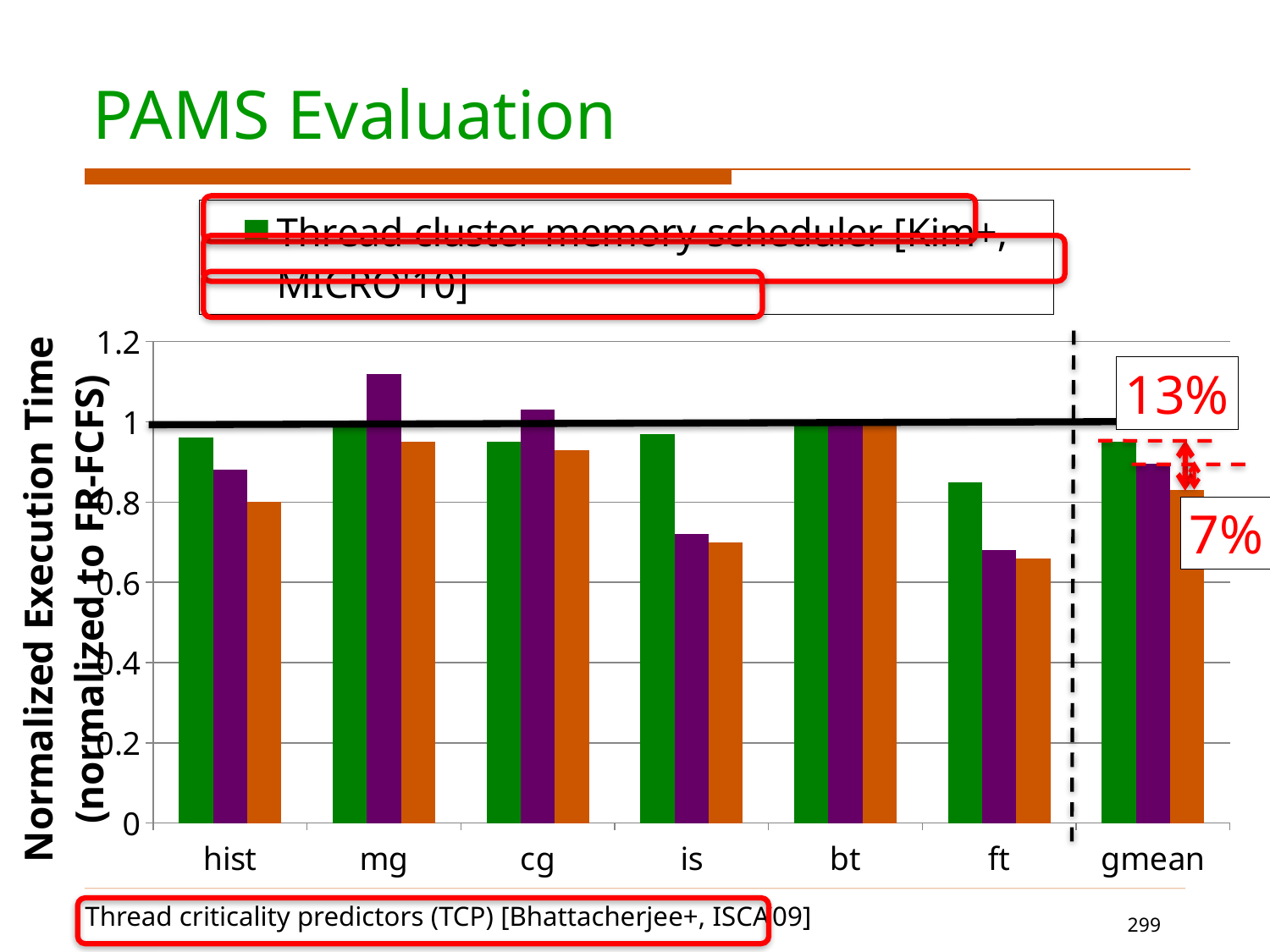
Is the purple bar for mg greater or less than 1? greater Which category has the shortest orange bar? ft How many categories are shown on the x axis of the chart? 7 Which category has the tallest purple bar? mg Is the purple bar for is greater or less than 0.8? less For mg, which is larger: the purple bar or the orange bar? purple bar How many bars (series) are plotted for each category in the chart? 3 What is the y-axis title of the chart? Normalized Execution Time (normalized to FR-FCFS) What kind of chart is shown on the slide? bar chart Is the green bar for hist greater or less than 1? less What two percentage values are annotated in red next to the gmean bars? 13% and 7%